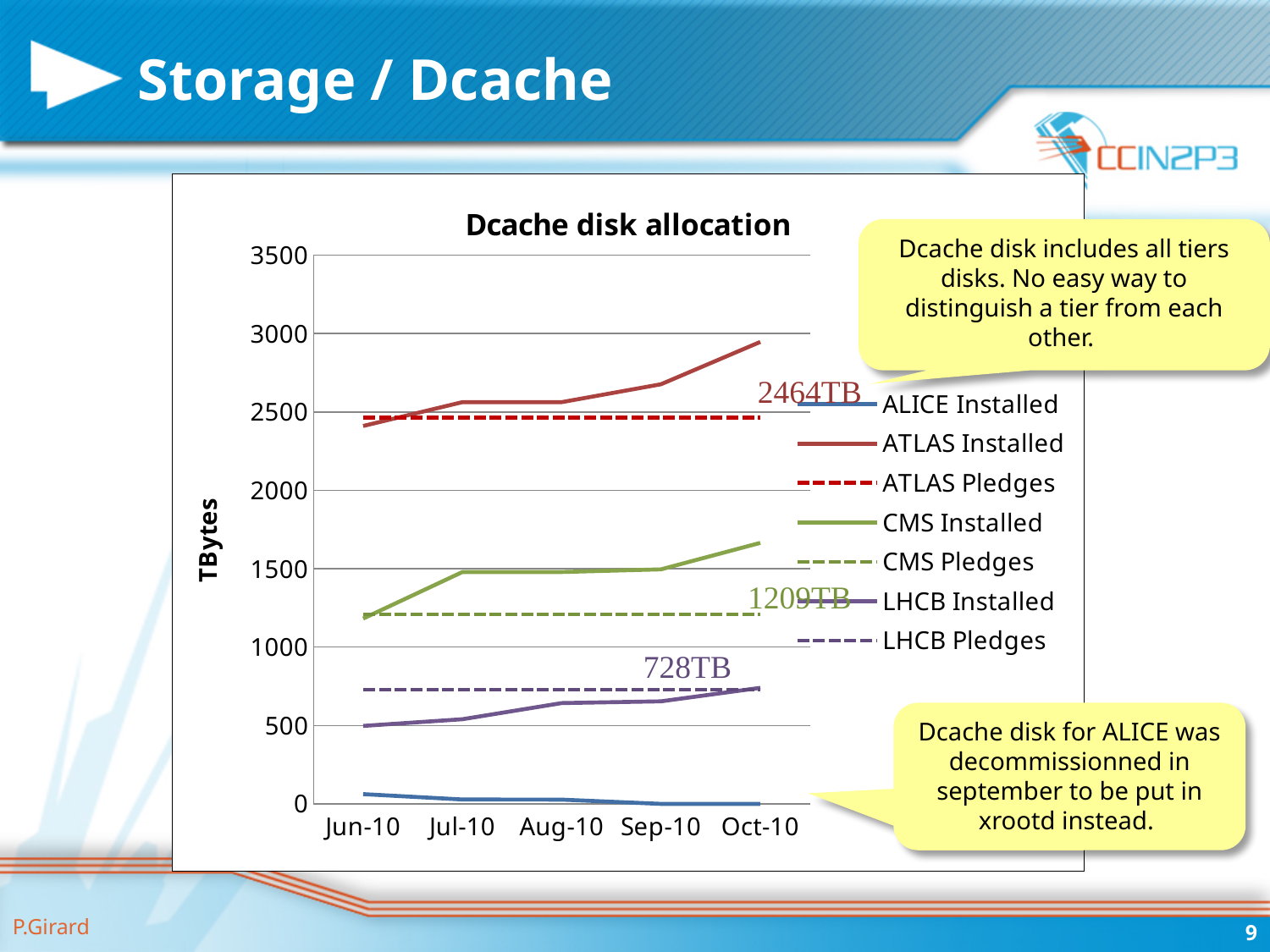
How many series does the chart legend list? 7 Which series has the highest value in Oct-10? ATLAS Installed How many months are shown along the x axis of the chart? 5 Which series has the lowest values across the chart? ALICE Installed What value is labelled on the CMS Pledges line? 1209TB In Oct-10, which is larger: CMS Installed or LHCB Installed? CMS Installed What value is labelled on the ATLAS Pledges line? 2464TB Does the ATLAS Installed line rise or fall from Jun-10 to Oct-10? rise What kind of chart is shown on the slide? line chart What value is labelled on the LHCB Pledges line? 728TB Is the value for ATLAS Installed in Oct-10 greater or less than 2500? greater What is the title of the chart? Dcache disk allocation